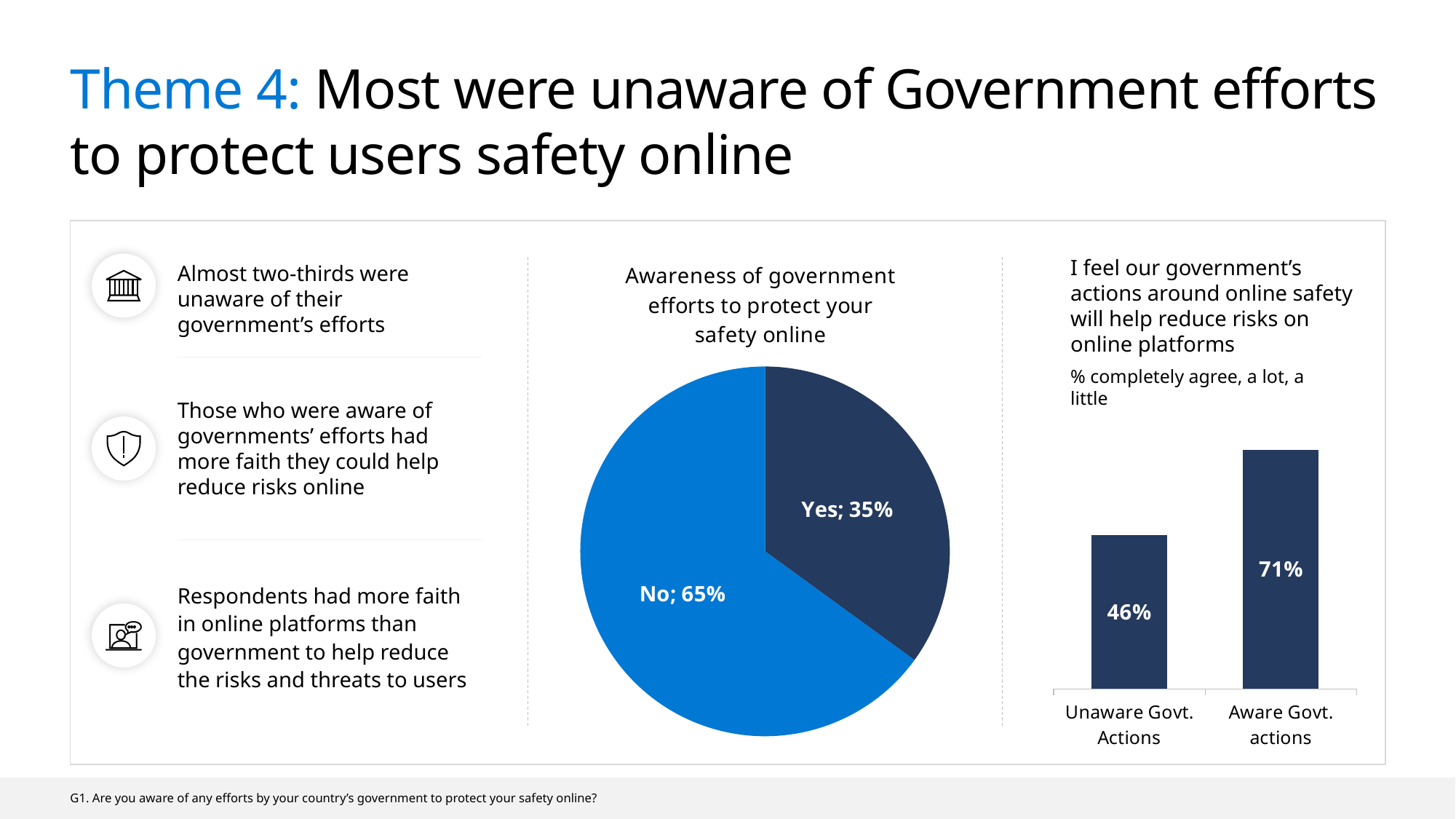
What kind of chart is the chart on the right of the slide? Bar chart In the bar chart on the right of the slide, what is the value for 'Unaware Govt. Actions'? 46% In the bar chart on the right of the slide, what is the value for 'Aware Govt. actions'? 71% In the pie chart on the slide, which slice is larger, Yes or No? No In the pie chart titled 'Awareness of government efforts to protect your safety online', what percentage answered Yes? 35% In the bar chart on the right of the slide, what is the difference between 'Aware Govt. actions' and 'Unaware Govt. Actions'? 25% In the pie chart titled 'Awareness of government efforts to protect your safety online', what percentage answered No? 65% What kind of chart is the chart in the middle of the slide? Pie chart In the pie chart on the slide, what is the difference between the No and Yes shares? 30% How many slices does the pie chart on the slide have? 2 In the pie chart on the slide, which colour is used for the No slice? Light blue In the bar chart on the right of the slide, which category has the highest value? Aware Govt. actions